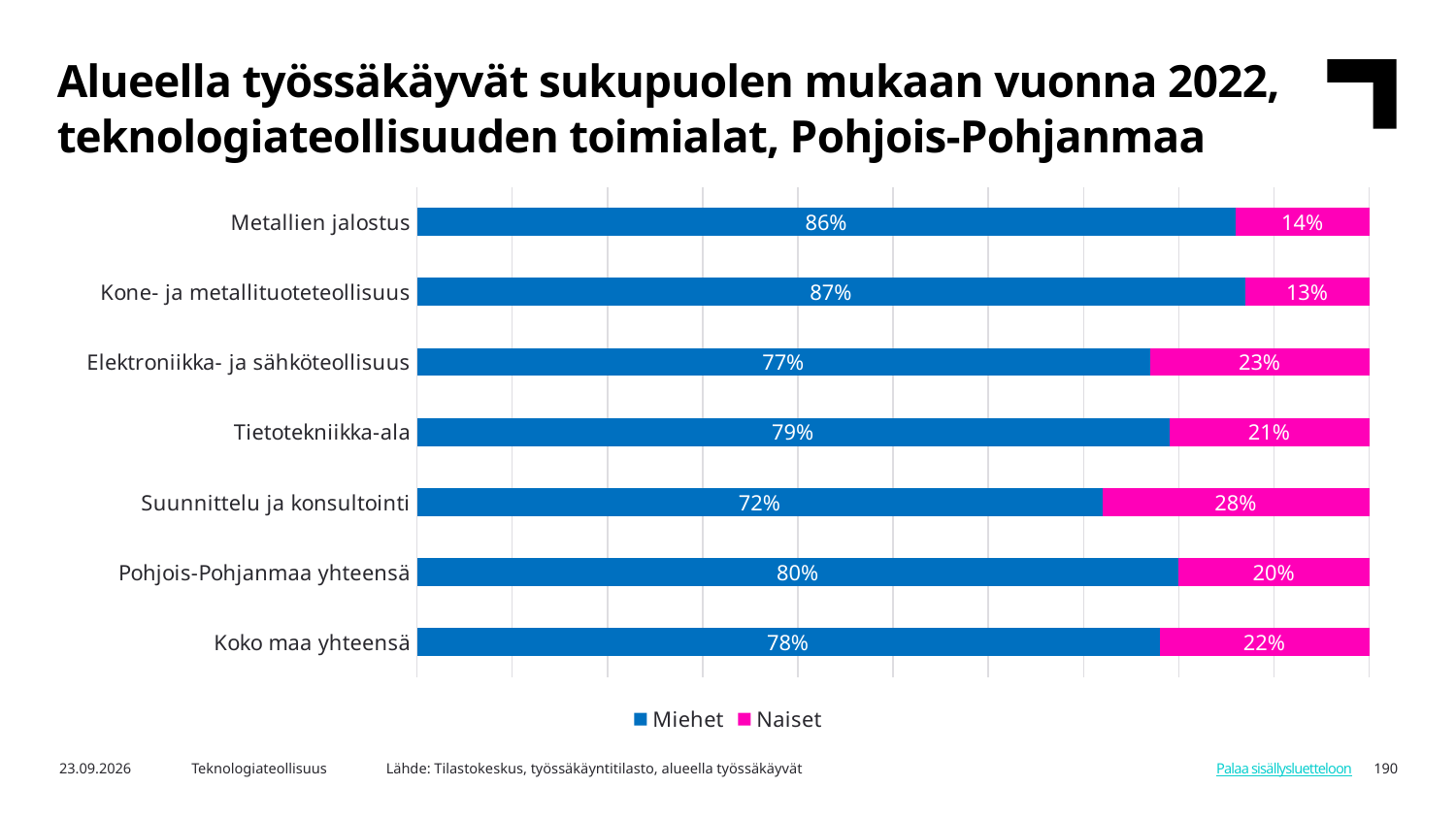
How many series does the legend list? 2 Which category has the highest Miehet share? Kone- ja metallituoteteollisuus What is the difference between the Miehet share for Metallien jalostus and for Suunnittelu ja konsultointi? 14 percentage points What kind of chart is shown on the slide? Stacked bar chart What is the Miehet share for Metallien jalostus? 86% Which is larger: the Naiset share for Elektroniikka- ja sähköteollisuus or for Tietotekniikka-ala? Elektroniikka- ja sähköteollisuus Which colour represents Naiset in the chart? Magenta (pink) What is the Naiset share for Suunnittelu ja konsultointi? 28% How many categories are shown on the chart? 7 Which category has the lowest Naiset share? Kone- ja metallituoteteollisuus What is the total of the stacked bar for Pohjois-Pohjanmaa yhteensä? 100% What is the Naiset share for Koko maa yhteensä? 22%